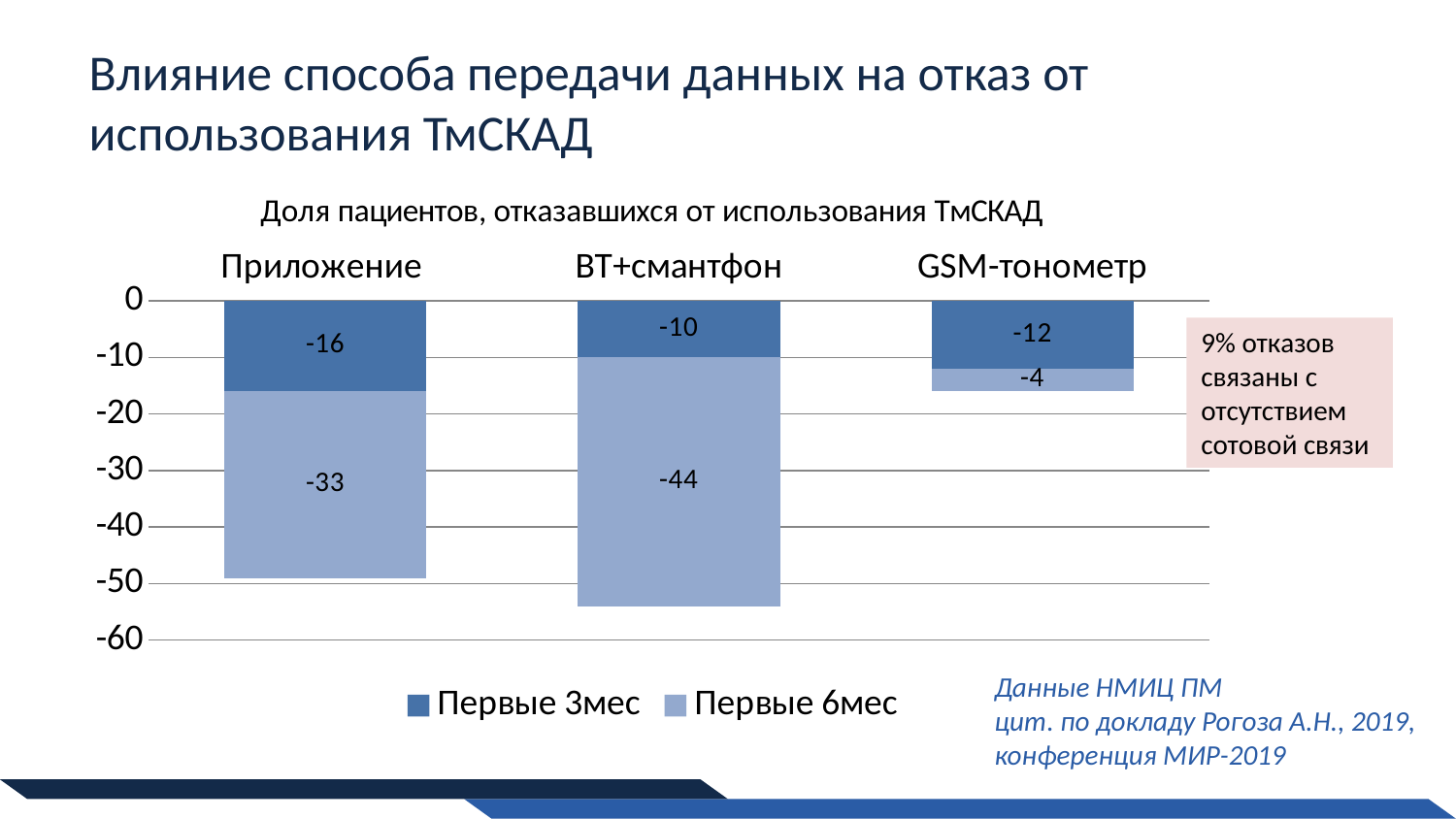
Which category has the largest 'Первые 6мес' value in magnitude? BT+смантфон How many categories are shown on the x axis of the chart? 3 What is the value for 'Первые 3мес' in the 'Приложение' category? -16 What is the value for 'Первые 6мес' in the 'GSM-тонометр' category? -4 What is the title of the chart? Доля пациентов, отказавшихся от использования ТмСКАД What is the total of the stacked bar for 'BT+смантфон'? -54 What type of chart is shown on the slide? Stacked bar chart What is the total of the stacked bar for 'Приложение'? -49 What is the value for 'Первые 6мес' in the 'BT+смантфон' category? -44 How many series does the chart legend list? 2 What is the value for 'Первые 3мес' in the 'GSM-тонометр' category? -12 What is the difference between the 'Первые 6мес' values for 'BT+смантфон' and 'Приложение'? 11